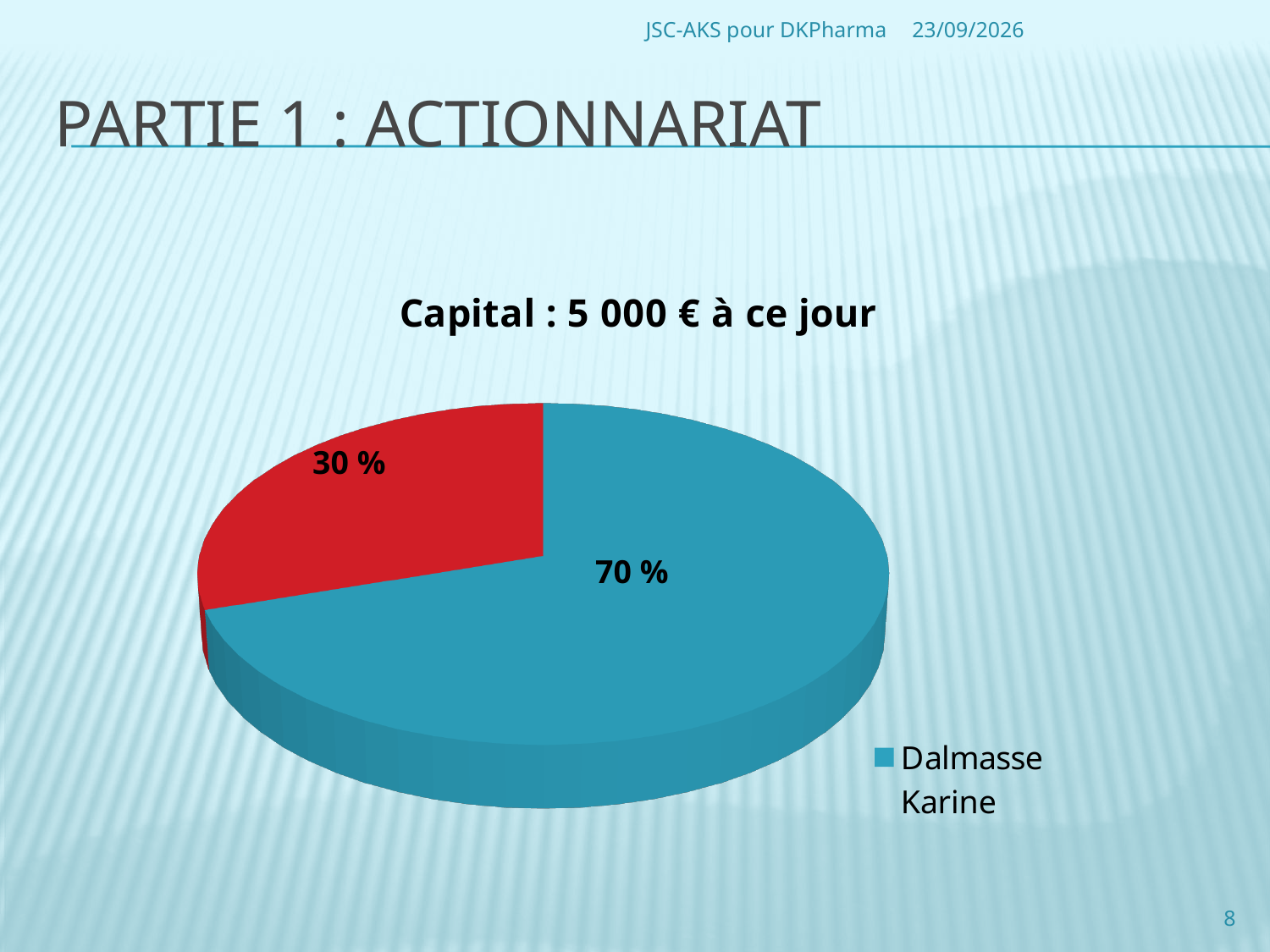
Which name appears in the legend of the pie chart? Dalmasse Karine What is the value shown on the largest slice of the pie? 70 % What is the total of the two slice percentages shown on the pie? 100 % What is the title of the chart? Capital : 5 000 € à ce jour What is the value shown on the smallest slice of the pie? 30 % Is the share held by Dalmasse Karine greater or less than 50 %? greater How many entries does the legend list? 1 What share of the pie does Dalmasse Karine hold? 70 % What is the difference in percentage points between the two slices of the pie? 40 What kind of chart is shown on the slide? pie chart Which slice is larger: the one labelled 70 % or the one labelled 30 %? 70 % How many slices does the pie chart have? 2